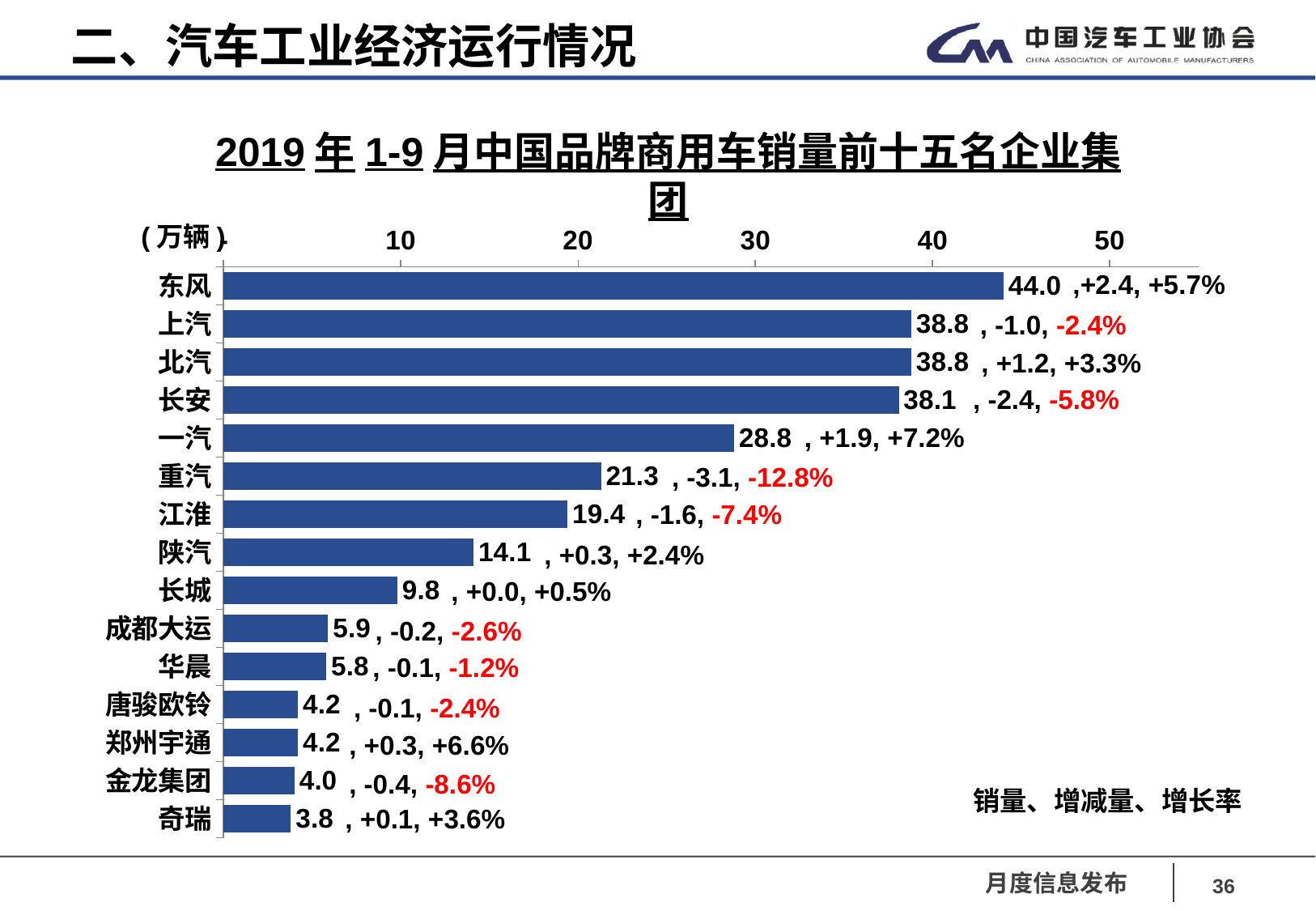
Which company has the lowest sales volume? 奇瑞 Is the sales volume for 长安 greater or less than 30? greater What is the sales volume (万辆) shown for 东风? 44.0 What kind of chart is shown on the slide? bar chart What is the change in volume shown for 一汽? +1.9 What is the sales volume shown for 长城? 9.8 How many companies are shown in the chart? 15 Which has the larger sales volume, 江淮 or 陕汽? 江淮 What unit is shown for the chart's axis? 万辆 What growth rate is shown for 重汽? -12.8% What is the difference in sales volume between 东风 and 一汽? 15.2 Which company has the highest sales volume? 东风